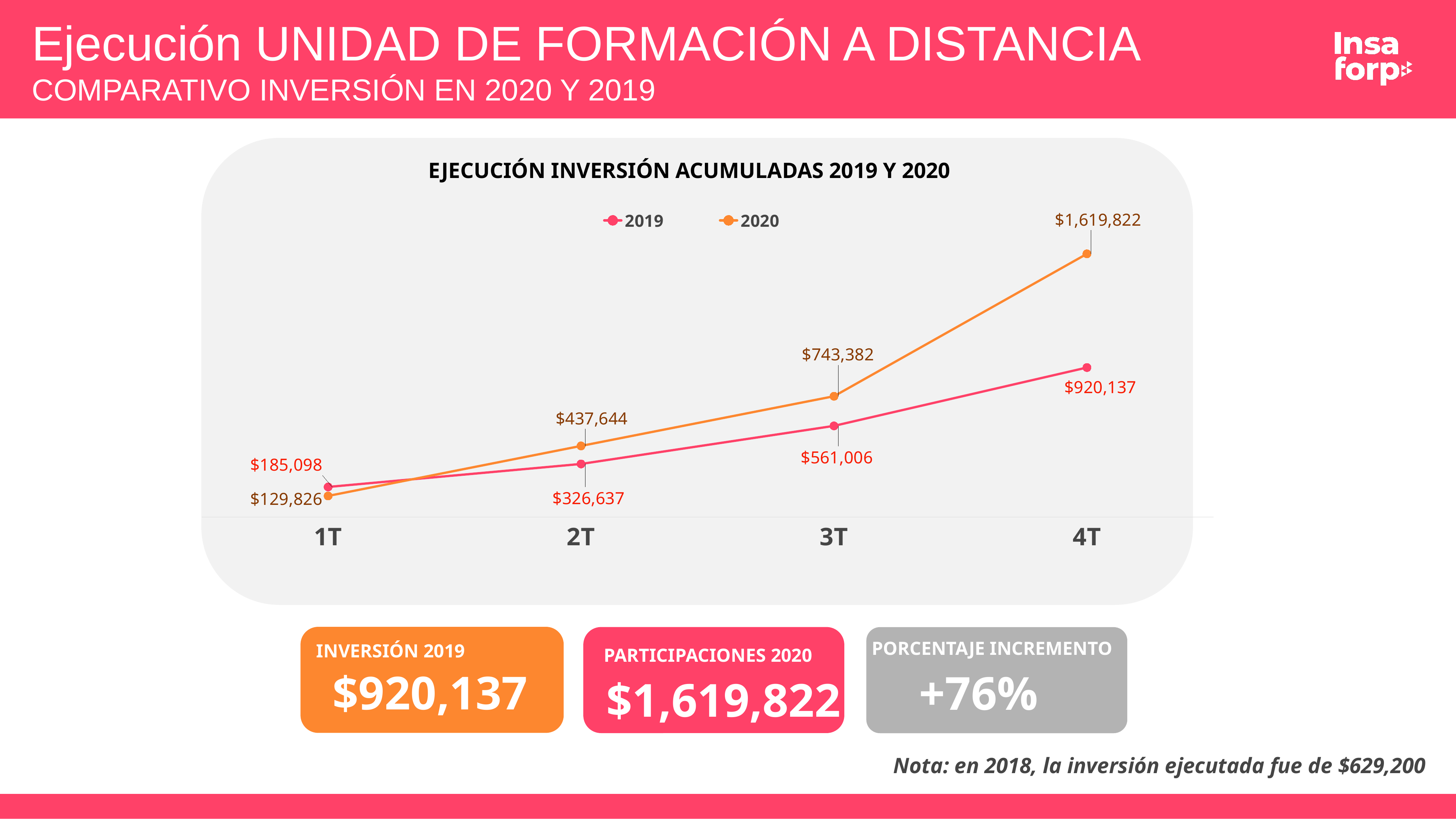
What is the 2020 value at 4T? $1,619,822 How many quarters are plotted on the x axis? 4 What is the difference between the 2020 and 2019 values at 4T? $699,685 What is the 2019 value at 2T? $326,637 At 1T, which series has the larger value, 2019 or 2020? 2019 How many series does the legend list? 2 What is the 2019 value at 3T? $561,006 In which quarter is the 2019 series at its lowest value? 1T What type of chart is shown on the slide? Line chart Do the 2020 values rise or fall from 1T to 4T? Rise In which quarter does the 2020 series reach its highest value? 4T What is the 2020 value at 1T? $129,826